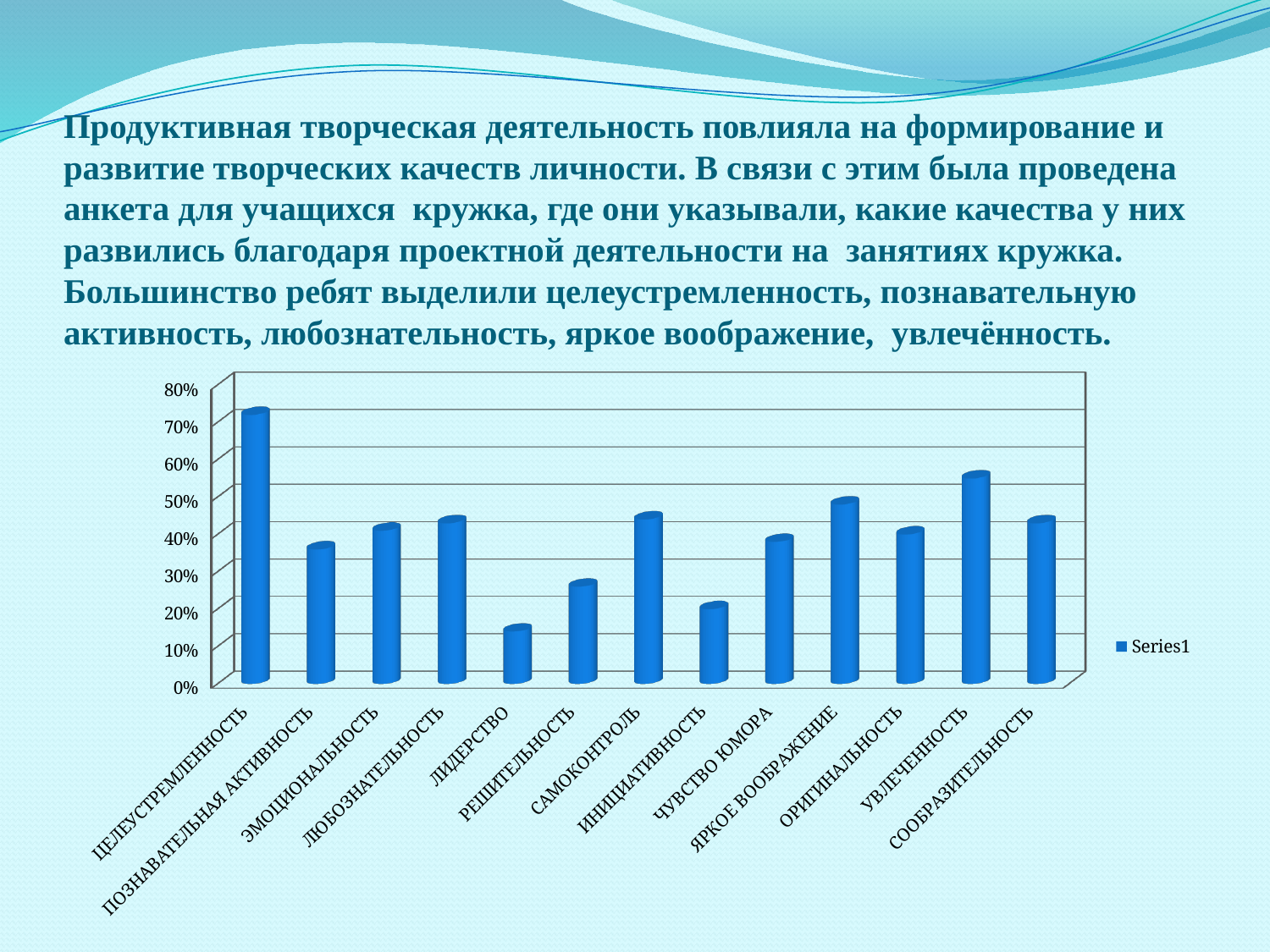
Is the value for ЛИДЕРСТВО greater or less than 20%? less Which is larger, the value for ЯРКОЕ ВООБРАЖЕНИЕ or the value for ИНИЦИАТИВНОСТЬ? ЯРКОЕ ВООБРАЖЕНИЕ Is the value for УВЛЕЧЕННОСТЬ greater or less than 50%? greater What is the legend entry shown on the chart? Series1 How many categories are plotted on the chart? 13 Is the value for ЦЕЛЕУСТРЕМЛЕННОСТЬ greater or less than 70%? greater Which category has the highest value on the chart? ЦЕЛЕУСТРЕМЛЕННОСТЬ How many series does the legend list? 1 What kind of chart is shown on the slide? bar chart Which category has the lowest value on the chart? ЛИДЕРСТВО Which is larger, the value for УВЛЕЧЕННОСТЬ or the value for РЕШИТЕЛЬНОСТЬ? УВЛЕЧЕННОСТЬ